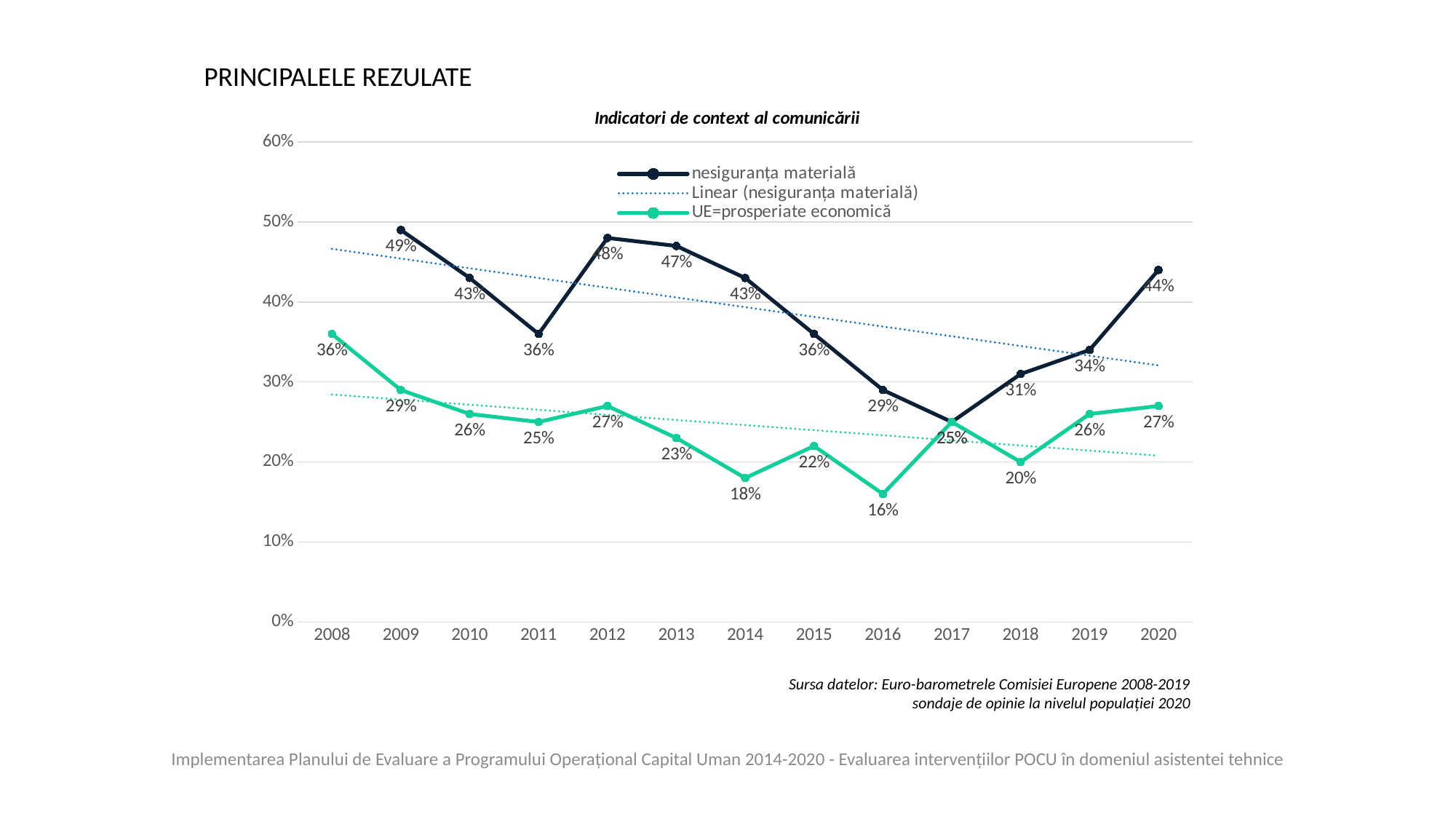
How many years are shown on the x axis? 13 What is the title of the chart? Indicatori de context al comunicării What is the difference between nesiguranța materială and UE=prosperiate economică in 2013? 24% Which is larger in 2017: nesiguranța materială or UE=prosperiate economică? They are equal (25%) What type of chart is shown on the slide? line chart In which year is nesiguranța materială at its highest? 2009 What is the value of nesiguranța materială in 2020? 44% What is the value of nesiguranța materială in 2009? 49% In which year is UE=prosperiate economică at its lowest? 2016 What is the value of UE=prosperiate economică in 2014? 18% In which year is nesiguranța materială at its lowest? 2017 How many entries does the legend list? 3